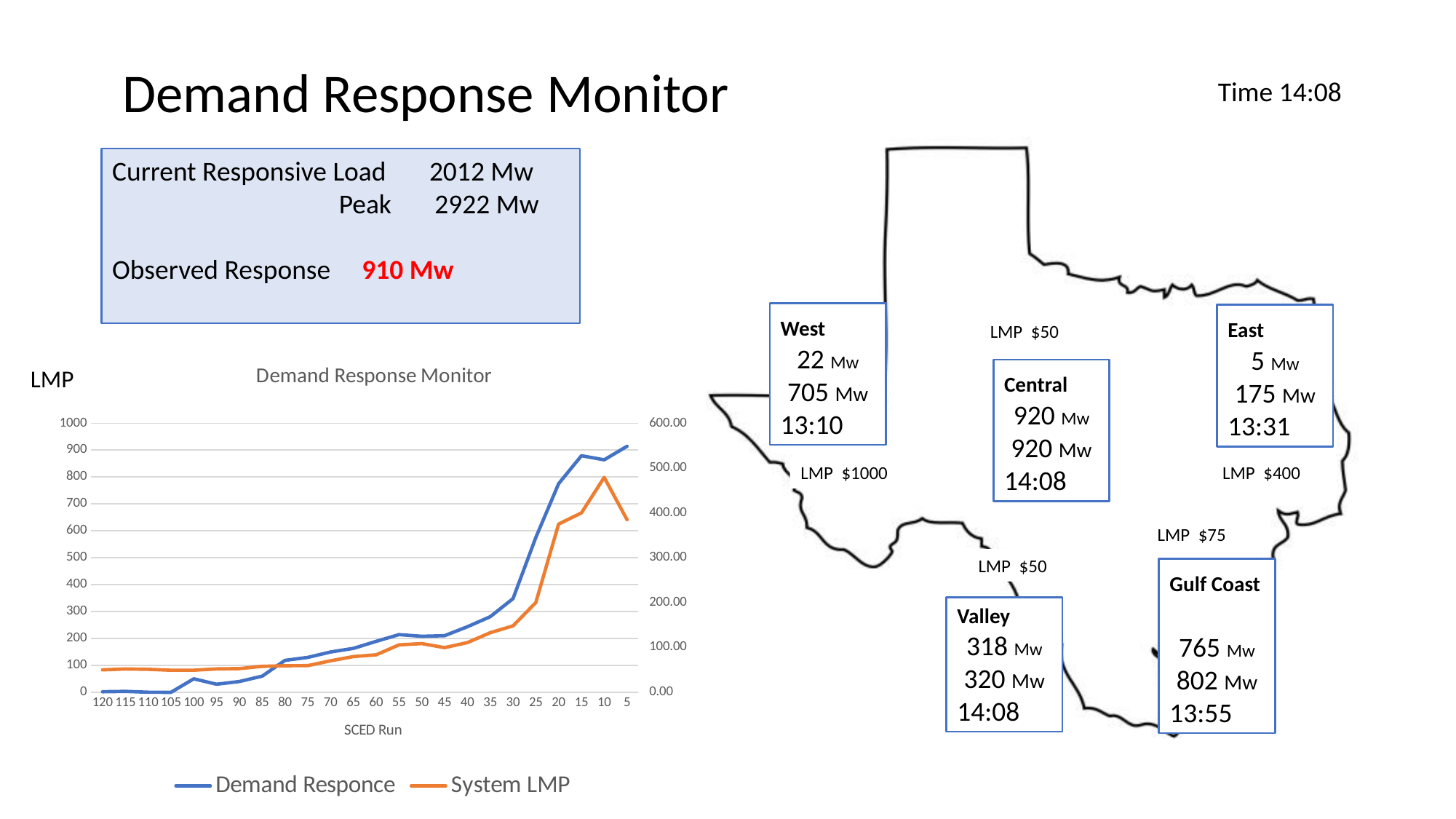
Is the Demand Responce value at SCED Run 15 greater or less than 800? greater Which is higher on the Demand Responce line: the value at SCED Run 30 or the value at SCED Run 120? SCED Run 30 What are the two series named in the legend of the Demand Response Monitor chart? Demand Responce and System LMP How many series does the legend of the Demand Response Monitor chart list? 2 What kind of chart is the Demand Response Monitor chart? line chart Is the System LMP value at SCED Run 10 greater or less than 400.00 on the right axis? greater At which SCED Run does the Demand Responce line reach its highest point? 5 What is the title of the x axis on the Demand Response Monitor chart? SCED Run How many SCED Run tick labels are shown along the x axis of the Demand Response Monitor chart? 24 Is the Demand Responce value at SCED Run 120 greater or less than 100? less Does the Demand Responce line rise or fall from left to right across the Demand Response Monitor chart? rise At which SCED Run does the System LMP line reach its highest point? 10